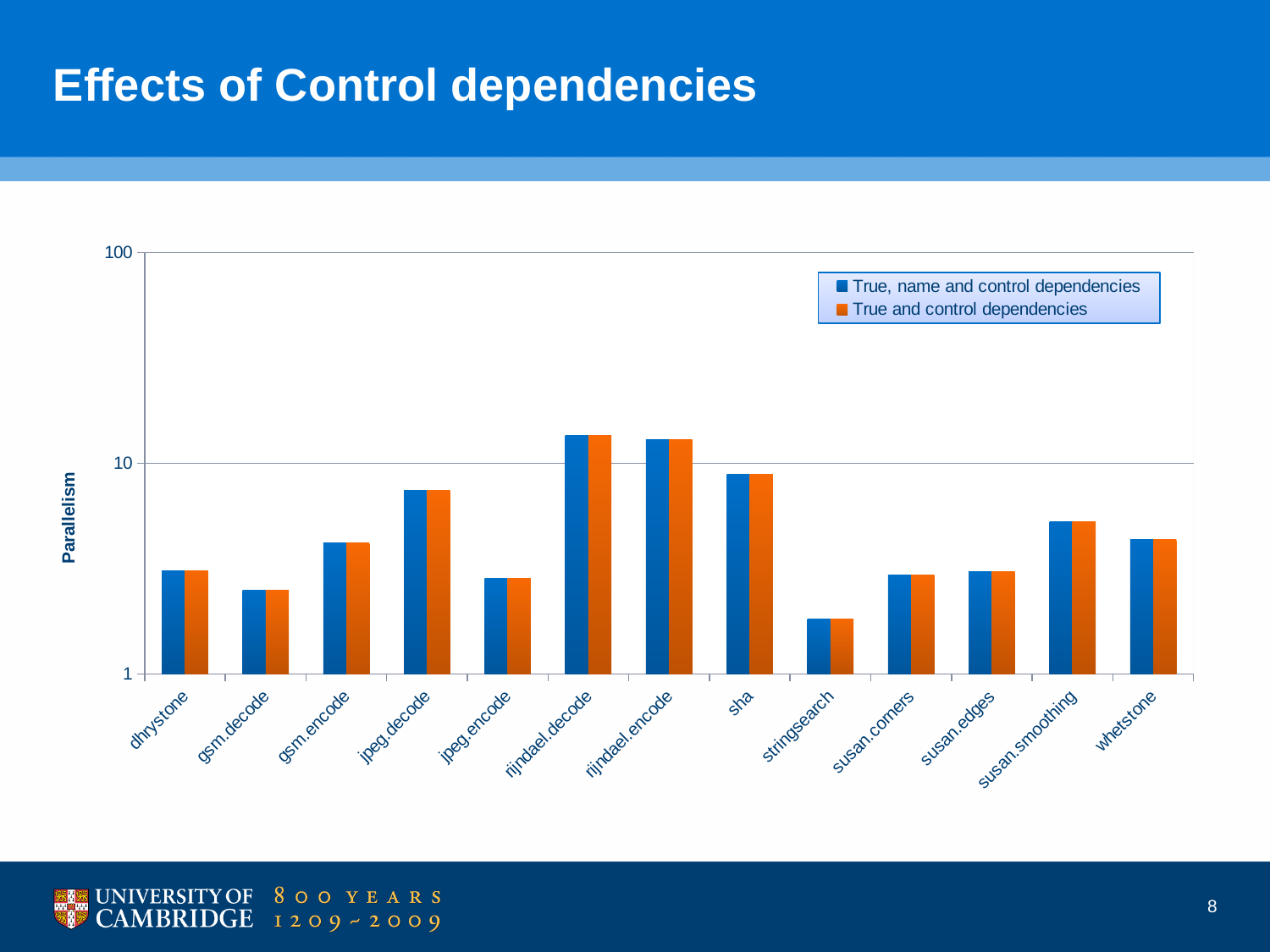
Which benchmark has the lowest parallelism? stringsearch Is the parallelism for jpeg.decode greater or less than 10? less Which has higher parallelism, susan.smoothing or susan.corners? susan.smoothing How many series does the legend list? 2 Which has higher parallelism, gsm.encode or gsm.decode? gsm.encode What is the label on the y axis? Parallelism Is the parallelism for stringsearch greater or less than 10? less Which series is shown in orange in the legend? True and control dependencies How many benchmark categories are plotted along the x axis? 13 What kind of chart is shown on the slide? bar chart Which has higher parallelism, jpeg.decode or jpeg.encode? jpeg.decode Is the parallelism for rijndael.decode greater or less than 10? greater